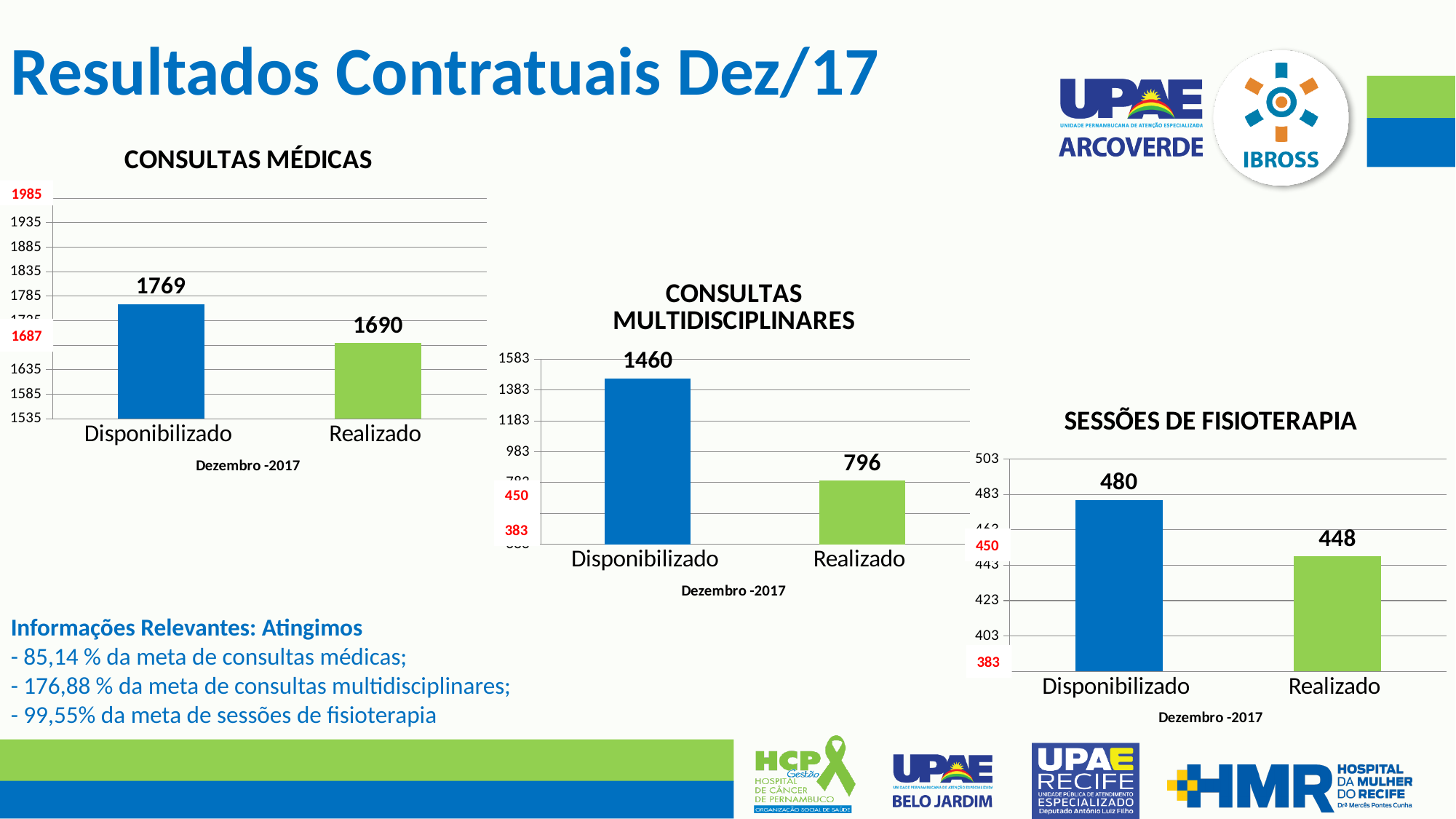
In the SESSÕES DE FISIOTERAPIA chart, which category has the highest value? Disponibilizado In the SESSÕES DE FISIOTERAPIA chart, what is the value for Realizado? 448 What kind of chart is the CONSULTAS MÉDICAS chart? Bar chart In the CONSULTAS MÉDICAS chart, what is the value for Disponibilizado? 1769 In the CONSULTAS MULTIDISCIPLINARES chart, what is the value for Realizado? 796 How many categories are shown in the SESSÕES DE FISIOTERAPIA chart? 2 In the CONSULTAS MÉDICAS chart, what is the difference between Disponibilizado and Realizado? 79 In the CONSULTAS MULTIDISCIPLINARES chart, what is the difference between Disponibilizado and Realizado? 664 In the CONSULTAS MULTIDISCIPLINARES chart, what is the value for Disponibilizado? 1460 In the CONSULTAS MÉDICAS chart, what is the value for Realizado? 1690 In the SESSÕES DE FISIOTERAPIA chart, what is the difference between Disponibilizado and Realizado? 32 In the CONSULTAS MULTIDISCIPLINARES chart, which category has the lowest value? Realizado